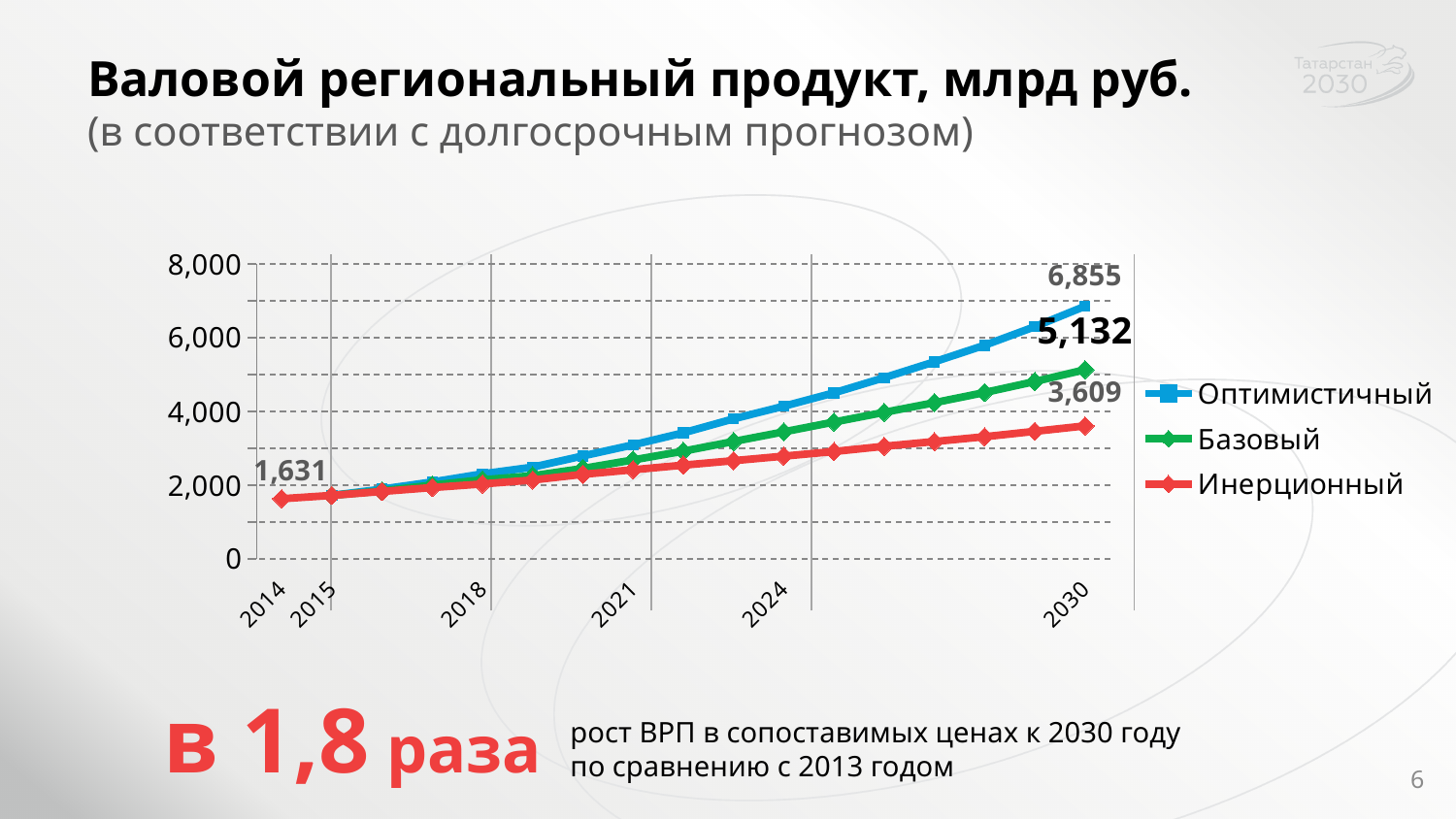
Do the values of the Базовый series rise or fall from 2014 to 2030? Rise Which series reaches the highest value in 2030? Оптимистичный What value is labelled at the start of the lines in 2014? 1,631 What is the value of the Базовый series in 2030? 5,132 What is the value of the Оптимистичный series in 2030? 6,855 Which series has the higher value in 2030, Базовый or Инерционный? Базовый What is the value of the Инерционный series in 2030? 3,609 Is the value for the Инерционный series in 2024 greater or less than 4,000? less What kind of chart is shown on the slide? Line chart How many series does the legend list? 3 What is the difference between the Оптимистичный and Базовый values in 2030? 1,723 What is the difference between the Оптимистичный and Инерционный values in 2030? 3,246